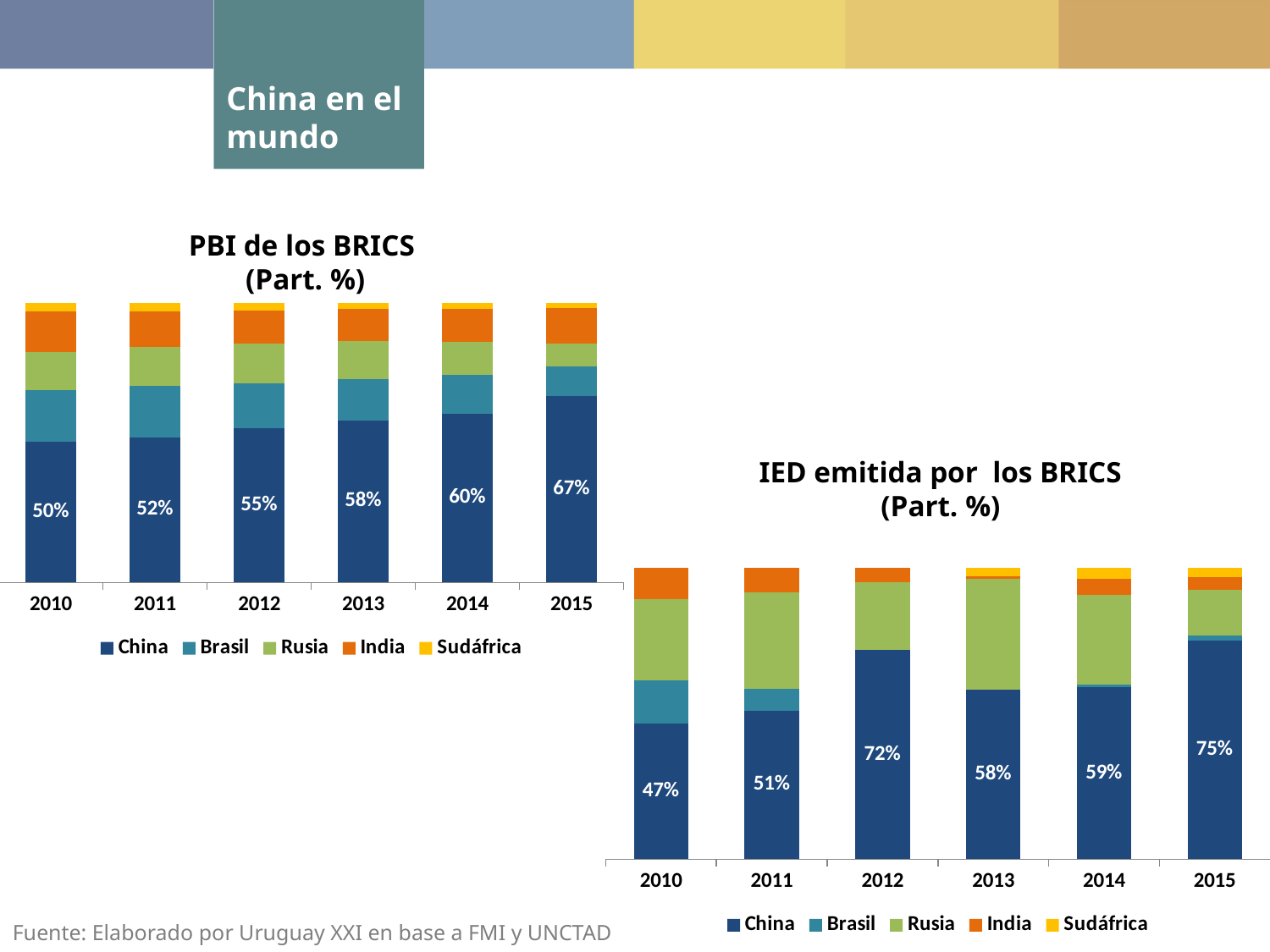
In the 'PBI de los BRICS (Part. %)' chart, what is China's share in 2015? 67% In the 'PBI de los BRICS (Part. %)' chart, what is China's share in 2010? 50% What kind of chart is the 'IED emitida por los BRICS (Part. %)' chart? Stacked bar chart In the 'IED emitida por los BRICS (Part. %)' chart, in which year is China's share highest? 2015 In the 'PBI de los BRICS (Part. %)' chart, does China's share rise or fall from 2010 to 2015? Rise In the 'PBI de los BRICS (Part. %)' chart, by how many percentage points did China's share increase from 2010 to 2015? 17 percentage points In the 'IED emitida por los BRICS (Part. %)' chart, what is China's share in 2010? 47% In the 'PBI de los BRICS (Part. %)' chart, in which year is China's share lowest? 2010 In the 'IED emitida por los BRICS (Part. %)' chart, which year has the larger China share, 2012 or 2013? 2012 How many series does the legend of the 'PBI de los BRICS (Part. %)' chart list? 5 In the 'IED emitida por los BRICS (Part. %)' chart, what is China's share in 2012? 72% How many years are shown on the x axis of the 'IED emitida por los BRICS (Part. %)' chart? 6